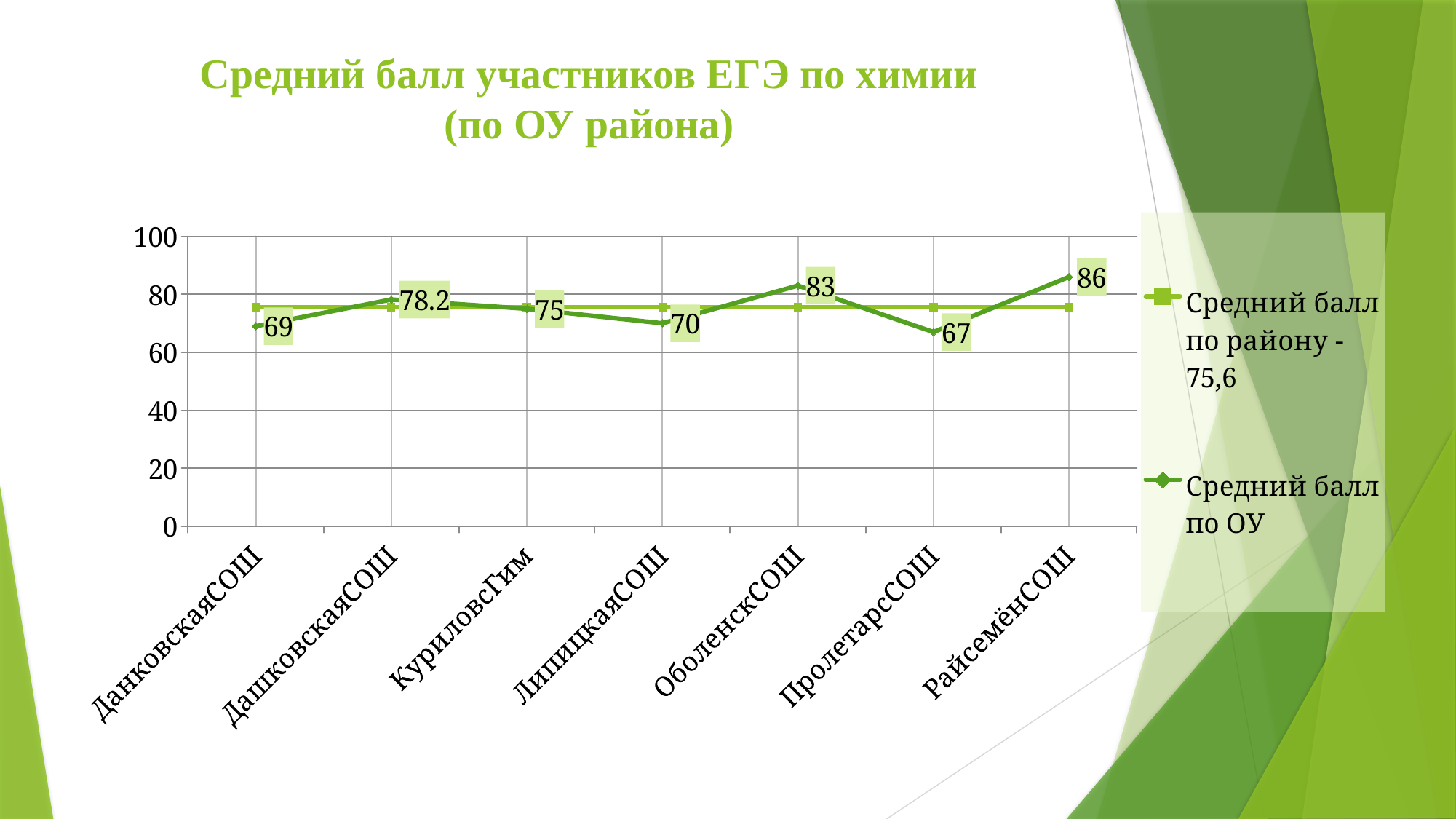
How many series does the legend list? 2 What is the difference between the average scores of РайсемёнСОШ and ДанковскаяСОШ? 17 What is the average score for ДашковскаяСОШ? 78.2 Which school has the highest average score? РайсемёнСОШ What district average score is stated in the legend? 75,6 What is the average score for ОболенскСОШ? 83 Which has a higher average score, КуриловсГим or ЛипицкаяСОШ? КуриловсГим Which school has the lowest average score? ПролетарсСОШ How many schools are shown on the x axis? 7 Is the value for ОболенскСОШ greater or less than 80? greater What is the average score for ПролетарсСОШ? 67 What kind of chart is shown on the slide? line chart